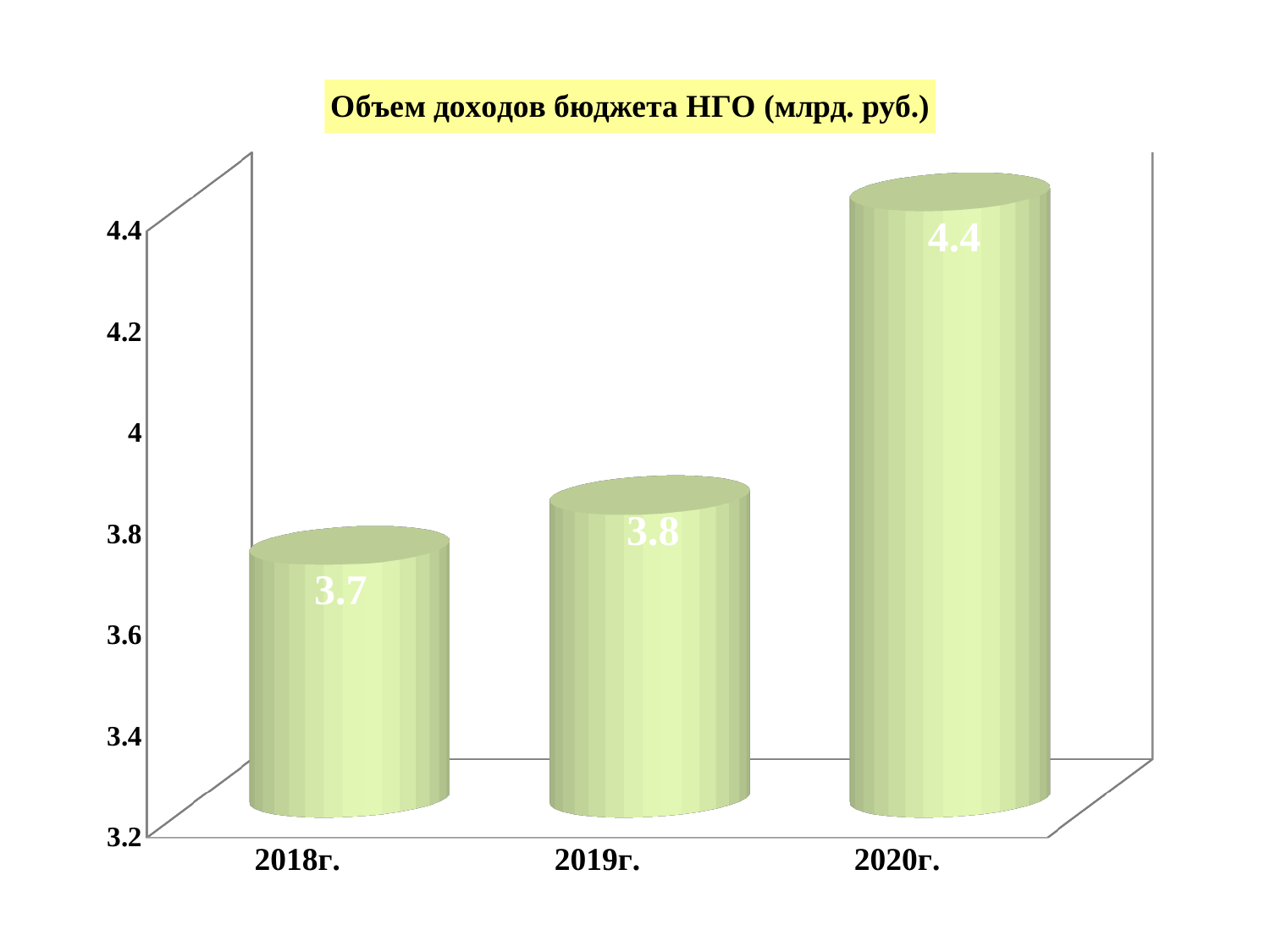
What is the value for 2020г.? 4.4 What kind of chart is this? bar chart What is the difference between the values for 2020г. and 2018г.? 0.7 What is the value for 2019г.? 3.8 What is the value for 2018г.? 3.7 Which year has the highest value? 2020г. What is the difference between the values for 2019г. and 2018г.? 0.1 Is the value for 2020г. greater or less than 4? greater Do the values rise or fall from 2018г. to 2020г.? rise Which year has the lowest value? 2018г. How many years are shown on the chart? 3 Which is larger, the value for 2020г. or the value for 2019г.? 2020г.